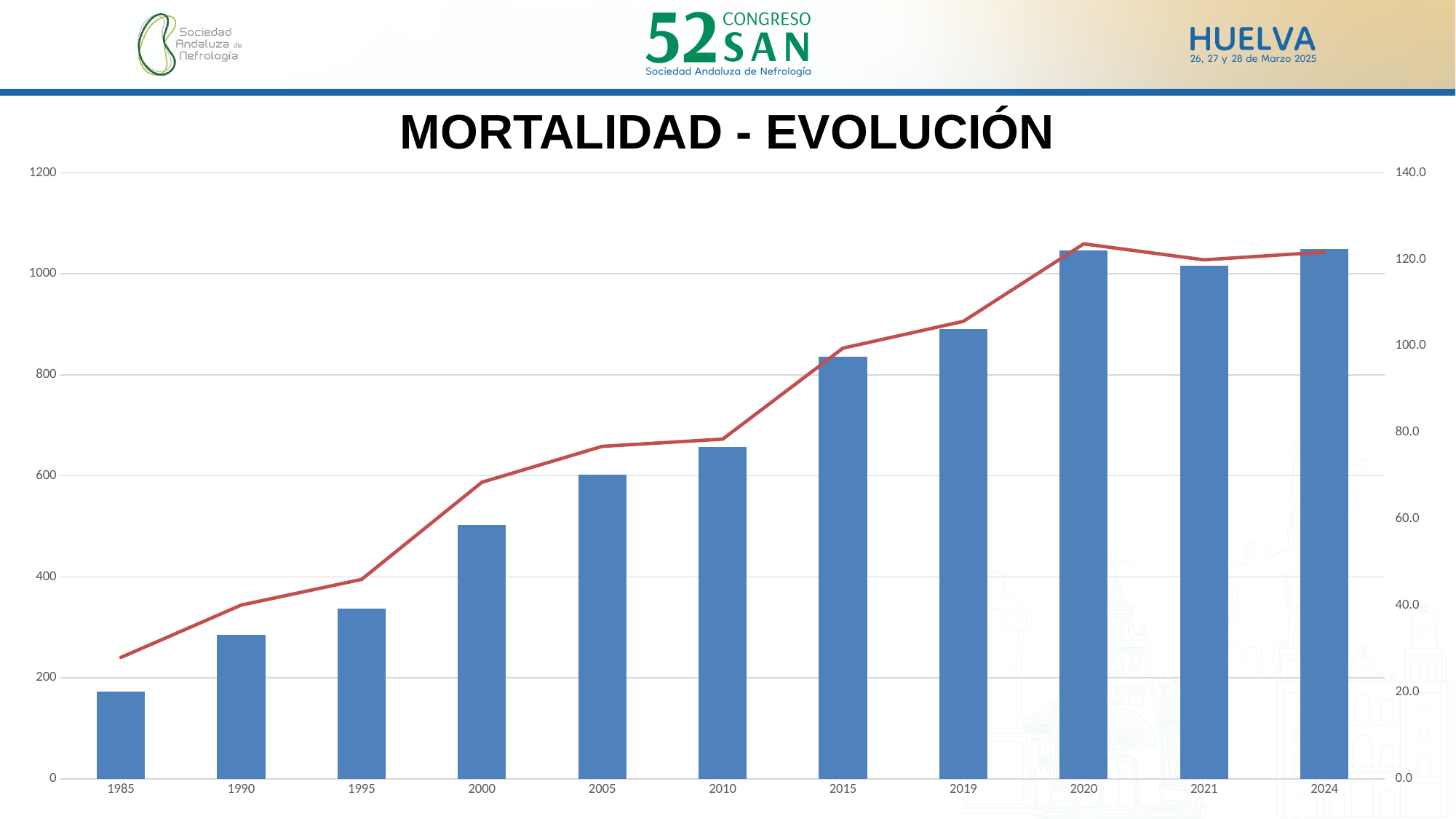
Is the bar value for 1990 greater or less than 400? less What is the title of the chart? MORTALIDAD - EVOLUCIÓN On the right-hand axis, is the red line value for 2020 greater or less than 120.0? greater Is the bar value for 2019 greater or less than 1000? less Do the bar values generally rise or fall from 1985 to 2024? Rise Which year has the lowest bar in the chart? 1985 How many years are shown on the x axis of the chart? 11 Which year has the taller bar, 2015 or 2010? 2015 What kind of chart is shown on the slide? A bar chart combined with a line